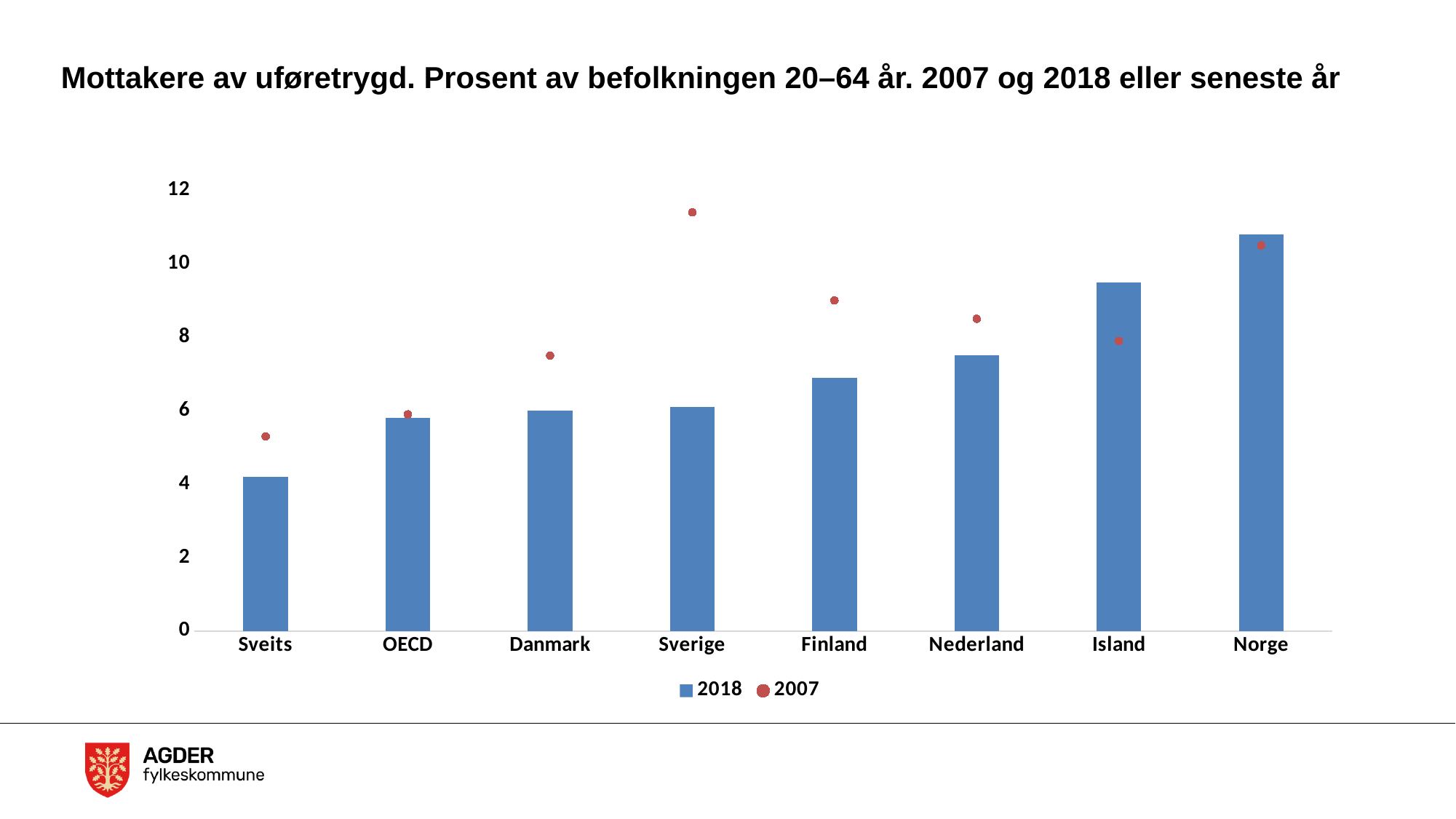
Which category has the highest 2018 value? Norge Is the 2018 value for Norge greater or less than 10? greater For Sverige, which is larger, the 2007 value or the 2018 value? 2007 How many series does the legend list? 2 What kind of chart is shown on the slide? bar chart Which category has the lowest 2018 value? Sveits Which category has the highest 2007 value? Sverige Is the 2018 value for Sveits greater or less than 6? less Which is larger, the 2018 value for Island or the 2018 value for Nederland? Island Do the 2018 bars rise or fall from left to right along the x axis? rise Which category has the lowest 2007 value? Sveits How many countries/categories are shown on the x axis? 8